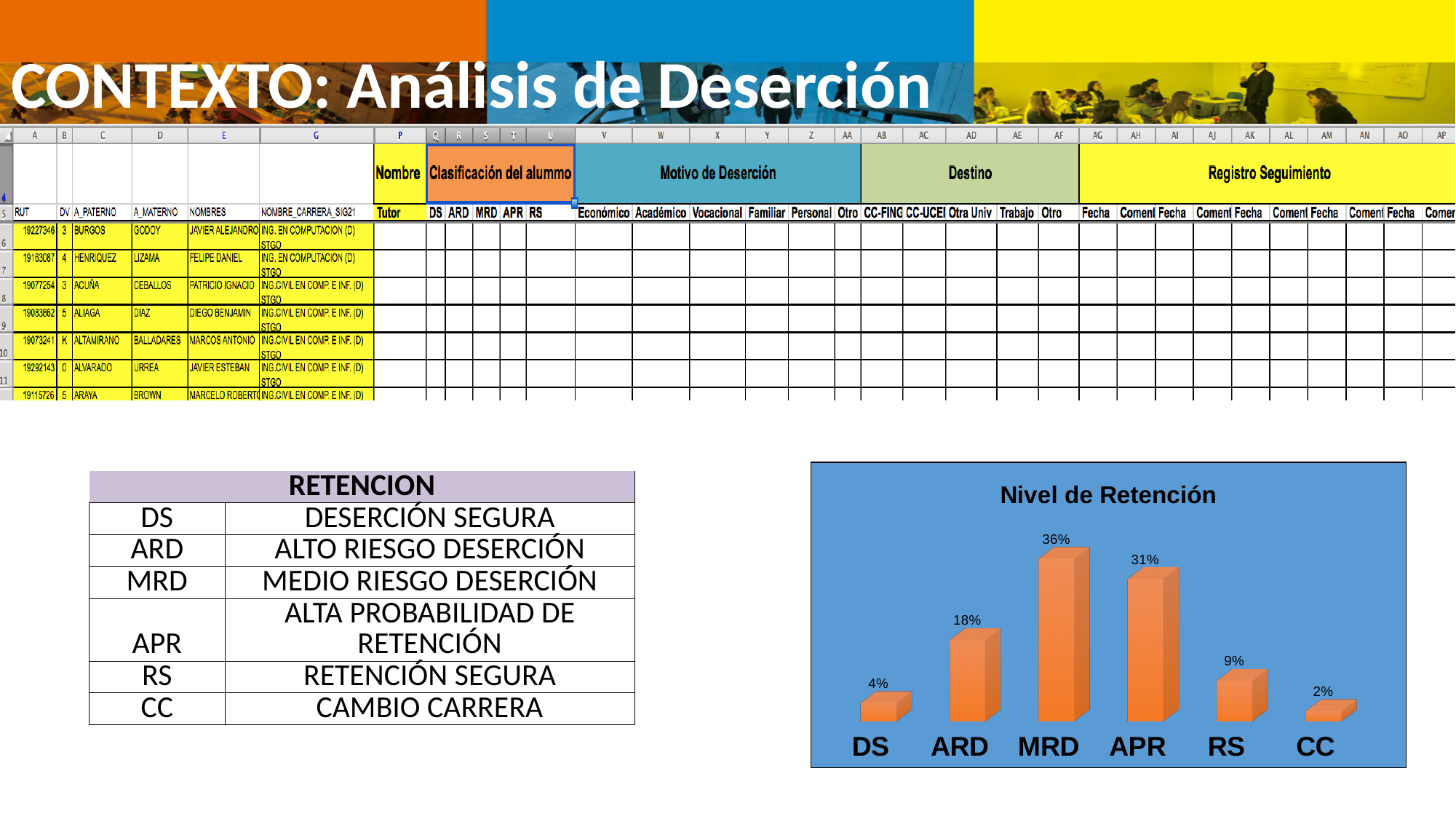
What is the difference between the values for MRD and APR in the Nivel de Retención chart? 5% What is the difference between the values for ARD and RS in the Nivel de Retención chart? 9% What is the title of the chart on the slide? Nivel de Retención What kind of chart is the Nivel de Retención chart? Bar chart Which category has the lowest value in the Nivel de Retención chart? CC Which is larger in the Nivel de Retención chart, ARD or RS? ARD What is the value for APR in the Nivel de Retención chart? 31% Which category has the highest value in the Nivel de Retención chart? MRD What is the value for CC in the Nivel de Retención chart? 2% How many categories are shown in the Nivel de Retención chart? 6 What is the value for MRD in the Nivel de Retención chart? 36% What is the value for DS in the Nivel de Retención chart? 4%